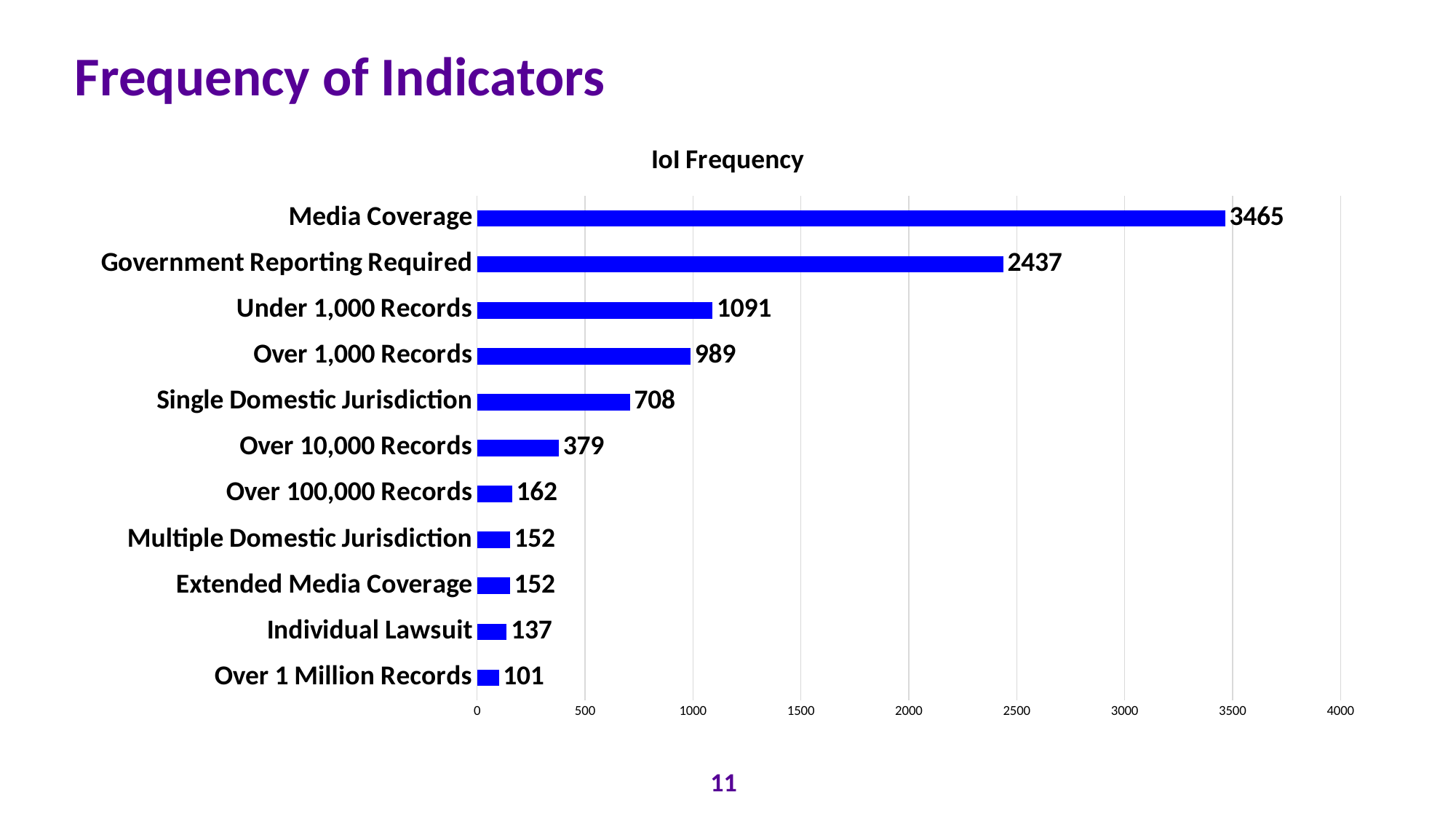
What kind of chart is shown on the slide? Bar chart Which category has the lowest value? Over 1 Million Records Which category has the highest value? Media Coverage Which is larger, Over 10,000 Records or Over 100,000 Records? Over 10,000 Records What is the difference between Media Coverage and Government Reporting Required? 1028 What is the title of the chart? IoI Frequency What is the value for Over 1 Million Records? 101 What is the value for Government Reporting Required? 2437 What is the value for Media Coverage? 3465 What is the value for Single Domestic Jurisdiction? 708 How many categories are shown in the chart? 11 What is the difference between Under 1,000 Records and Over 1,000 Records? 102